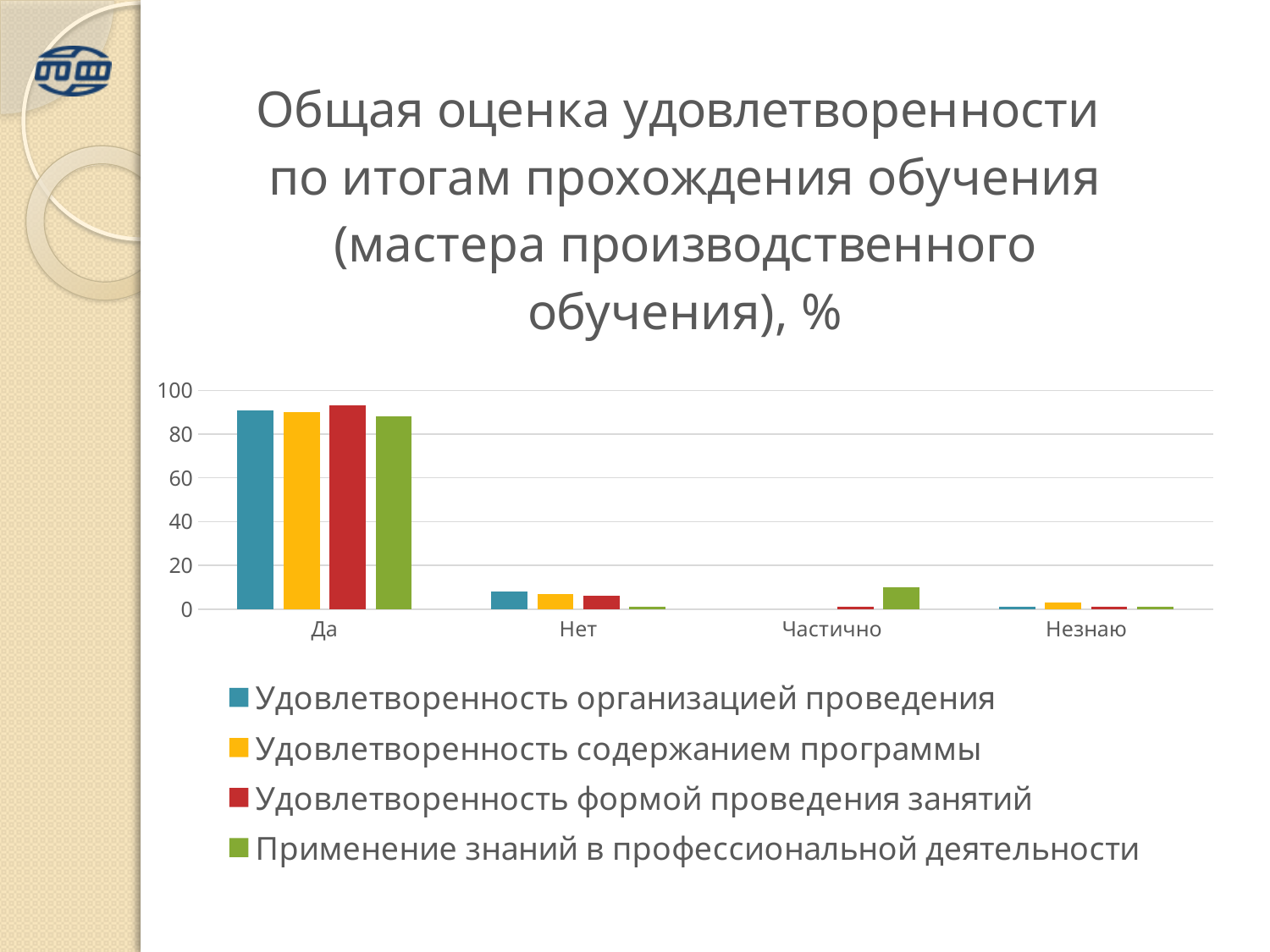
For the series "Удовлетворенность организацией проведения", which category has the larger value: "Да" or "Нет"? Да What kind of chart is shown on the slide? bar chart Which category has the highest value for the series "Удовлетворенность содержанием программы"? Да Is the value for "Да" in the series "Удовлетворенность организацией проведения" greater or less than 80? greater Which series is shown in green in the chart legend? Применение знаний в профессиональной деятельности Is the value for "Да" in the series "Удовлетворенность формой проведения занятий" greater or less than 60? greater How many categories are shown on the x axis of the chart? 4 How many series does the chart legend list? 4 For the category "Частично", which series has the larger value: "Применение знаний в профессиональной деятельности" or "Удовлетворенность формой проведения занятий"? Применение знаний в профессиональной деятельности Is the value for "Нет" in the series "Удовлетворенность содержанием программы" greater or less than 20? less What unit is indicated in the chart title? %